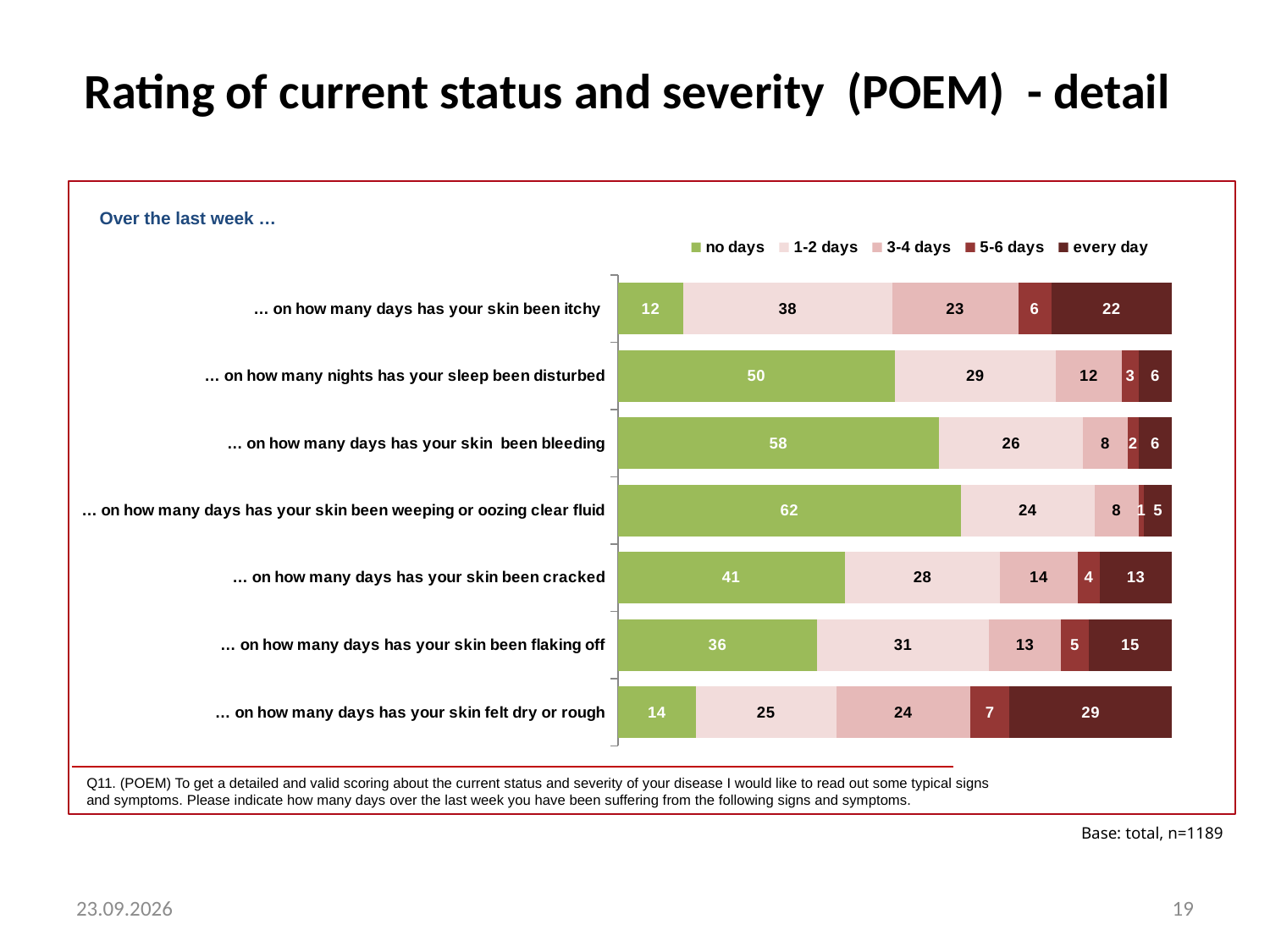
What kind of chart is shown on the slide? Stacked bar chart What is the value for "1-2 days" for "… on how many days has your skin been flaking off"? 31 What is the value for "every day" for "… on how many days has your skin felt dry or rough"? 29 Which category has the highest value for "no days"? … on how many days has your skin been weeping or oozing clear fluid What is the difference between the "no days" values for "… on how many days has your skin been bleeding" and "… on how many nights has your sleep been disturbed"? 8 Which is larger: the "every day" value for "… on how many days has your skin been itchy" or for "… on how many days has your skin been cracked"? … on how many days has your skin been itchy How many categories (symptom questions) are shown in the chart? 7 What is the total of the stacked bar for "… on how many days has your skin been cracked"? 100 Which category has the lowest value for "no days"? … on how many days has your skin been itchy What is the base (sample size) stated on the slide? n=1189 How many series does the legend list? 5 What is the value for "no days" for "… on how many days has your skin been itchy"? 12